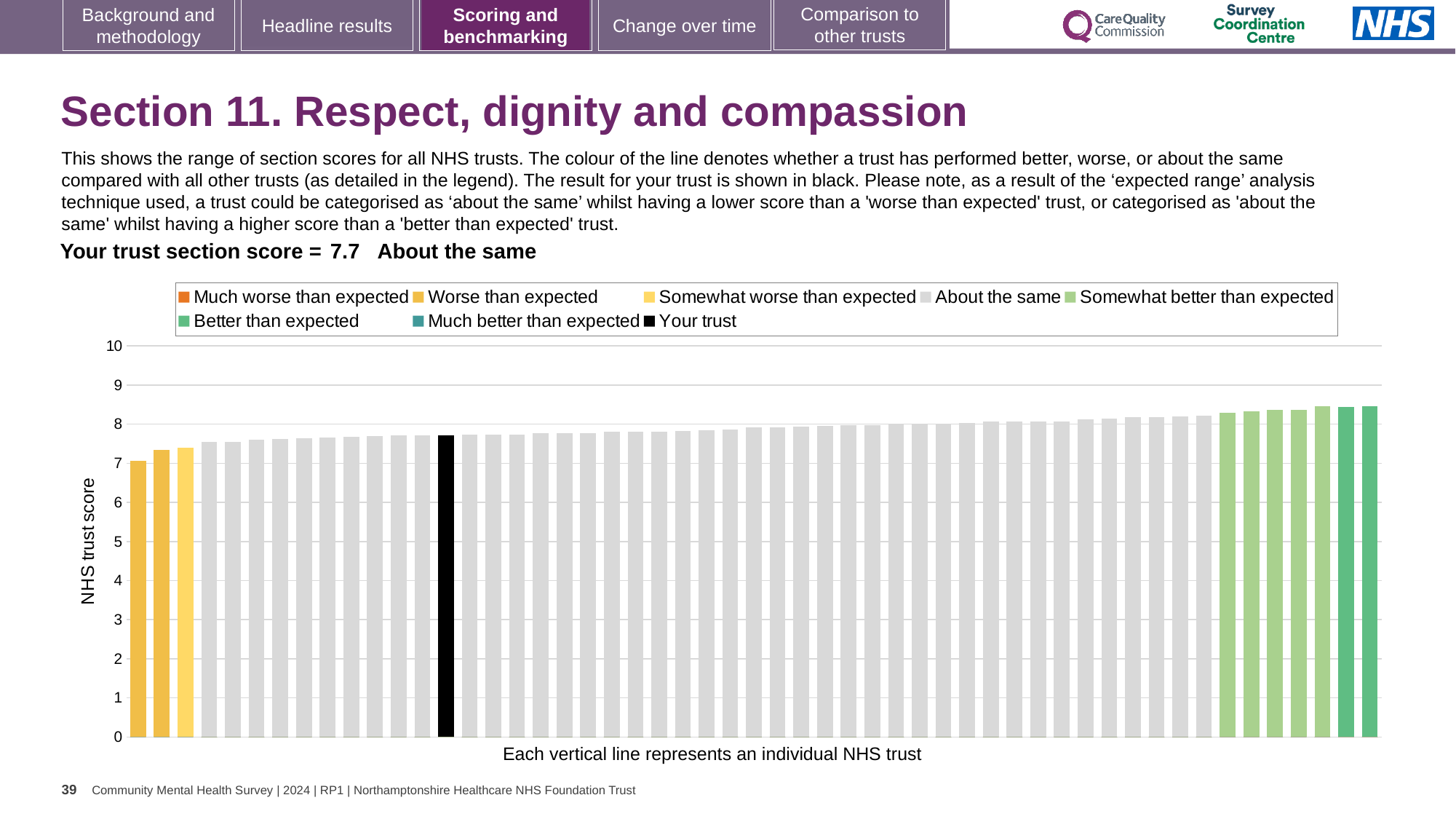
What is the label on the vertical axis of the chart? NHS trust score Do the bar values rise or fall moving from left to right along the x axis? rise Is the black bar for your trust higher or lower than the tallest dark green bar? lower Is the value of the highest bar in the chart greater or less than 8? greater Which category is your trust placed in for this section? About the same How many bars are coloured as 'Better than expected' (dark green)? 2 How many entries does the chart legend list? 8 Is the value of the lowest bar in the chart greater or less than 8? less What kind of chart is shown on the slide? bar chart Is the value of the black bar (your trust) greater or less than 5? greater What is the section score for your trust shown on the slide? 7.7